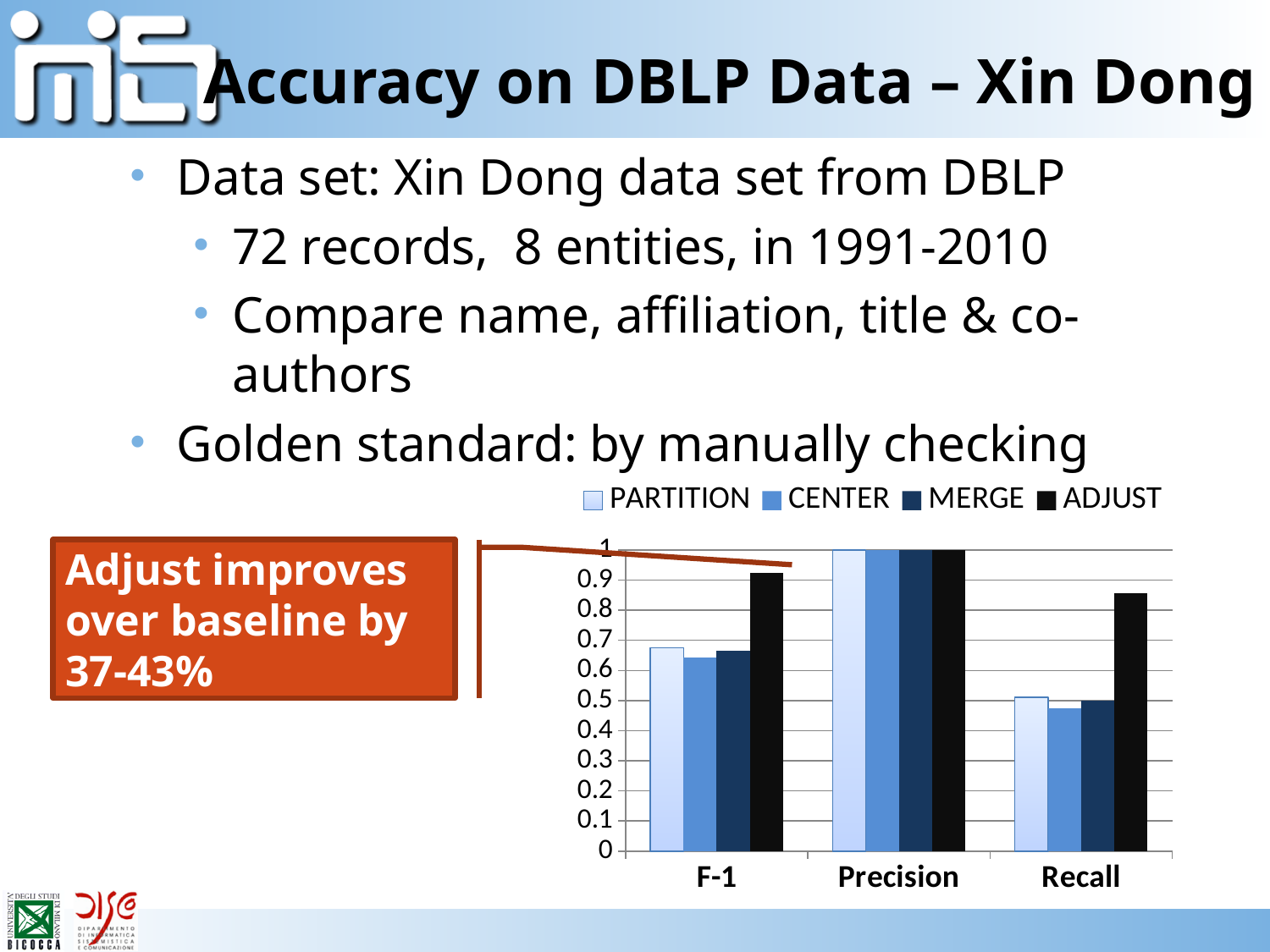
What is the ADJUST value for Precision? 1 Which series has the highest value for Recall? ADJUST How many series does the chart legend list? 4 Which series has the highest value for F-1? ADJUST Which series has the lowest value for Recall? CENTER How many categories are shown on the x axis of the chart? 3 Is the PARTITION value for F-1 greater or less than 0.6? greater Which series is drawn in black in the chart? ADJUST What kind of chart is shown on the slide? bar chart Which is larger: the ADJUST value for F-1 or the ADJUST value for Recall? F-1 Is the ADJUST value for F-1 greater or less than 0.8? greater